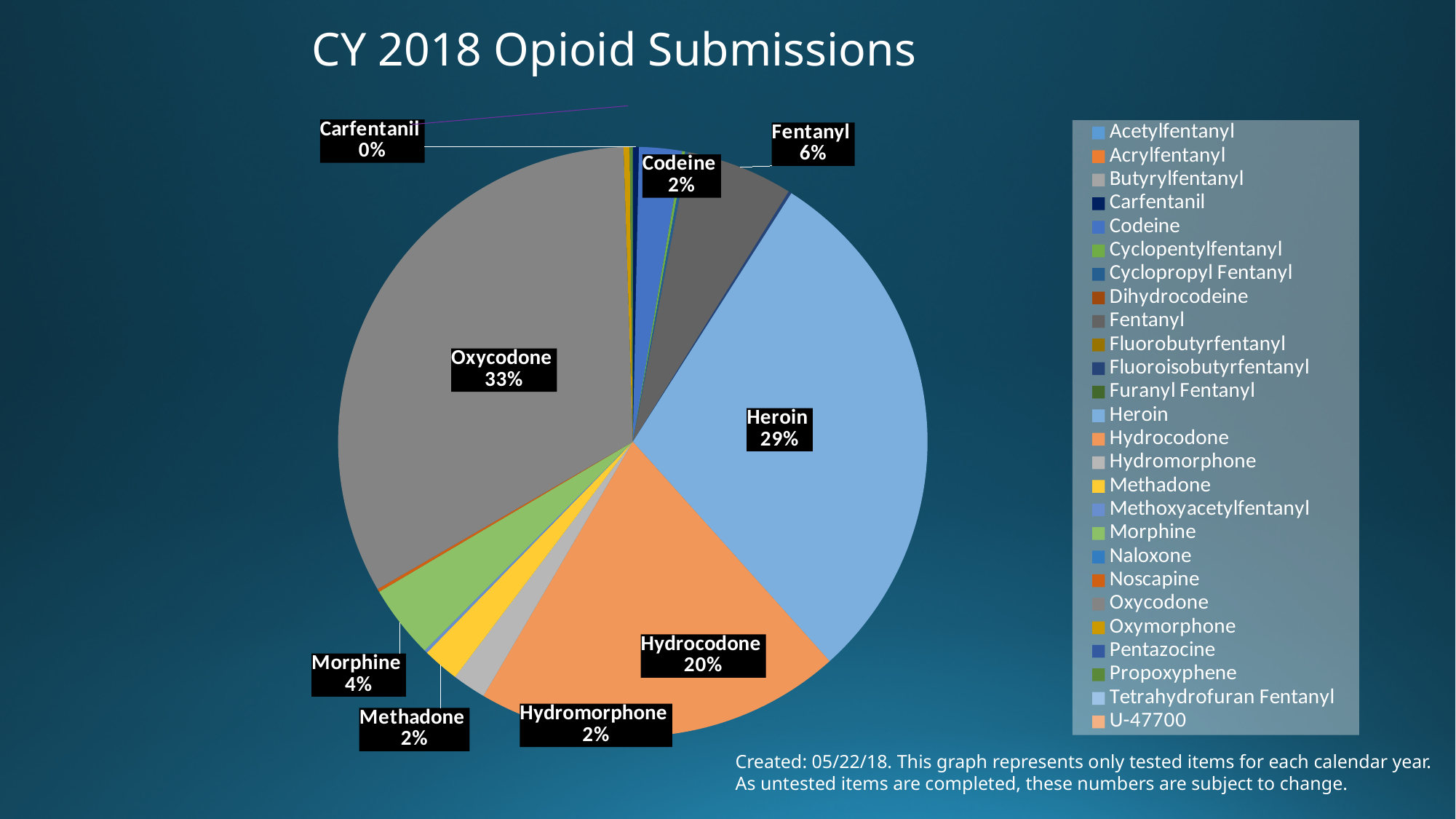
What share of the pie does Oxycodone represent? 33% Which has the larger share, Hydrocodone or Fentanyl? Hydrocodone How many percentage points larger is Oxycodone's share than Heroin's share? 4 What is the title of the chart? CY 2018 Opioid Submissions What percentage is labelled for Hydrocodone? 20% What percentage is labelled for Fentanyl? 6% How many entries does the legend list? 26 What share of the pie does Heroin represent? 29% What percentage is labelled for Carfentanil? 0% What percentage is labelled for Morphine? 4% What kind of chart is shown on the slide? pie chart Which labelled category has the largest share of the pie? Oxycodone